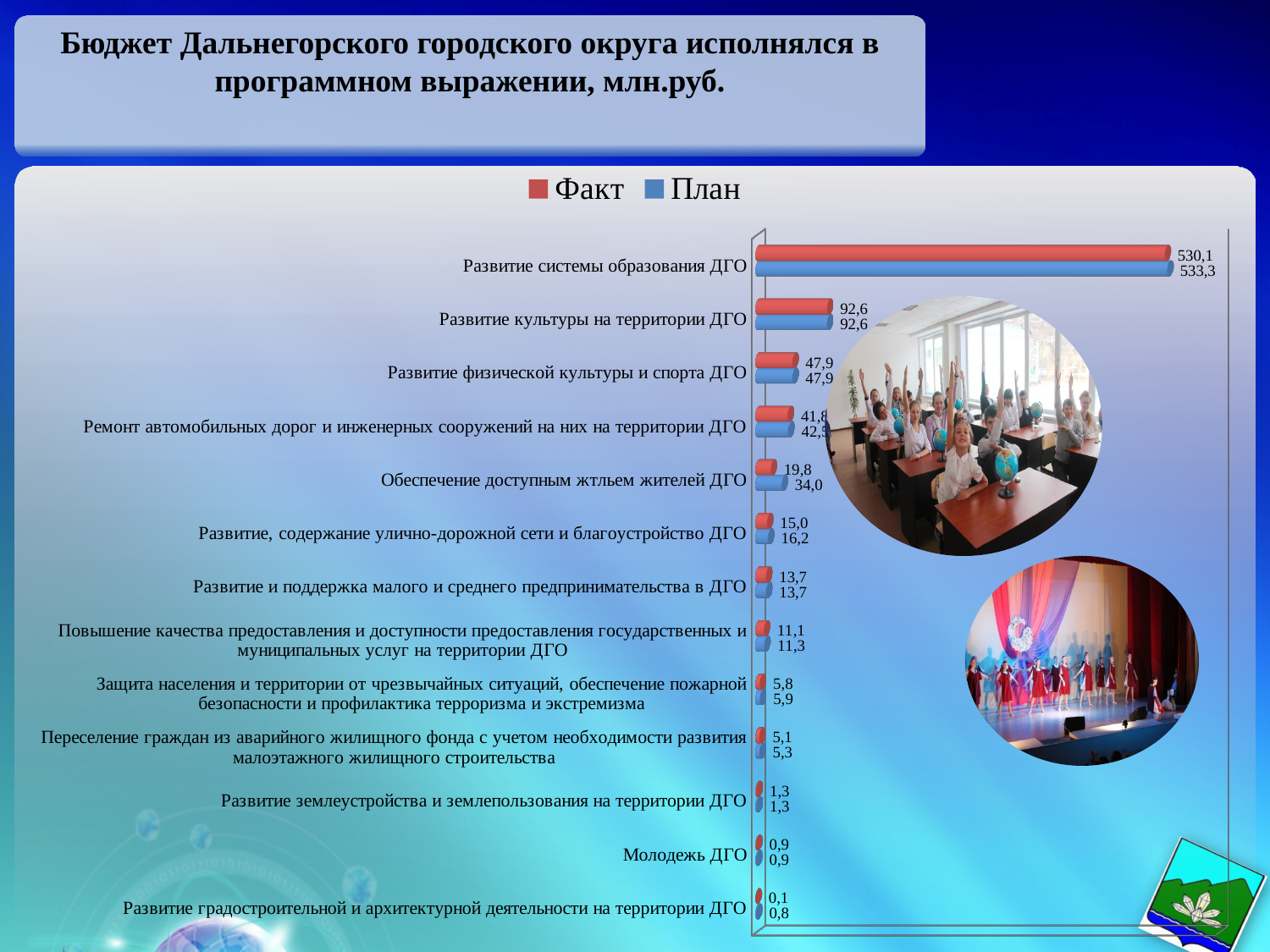
What type of chart is shown on the slide? Bar chart How many series does the legend list? 2 What is the План value for Развитие градостроительной и архитектурной деятельности на территории ДГО? 0,8 How many categories are shown in the chart? 13 Which category has the highest Факт value? Развитие системы образования ДГО Which is larger for Развитие, содержание улично-дорожной сети и благоустройство ДГО: the Факт value or the План value? План What is the Факт value for Развитие системы образования ДГО? 530,1 What is the Факт value for Развитие, содержание улично-дорожной сети и благоустройство ДГО? 15,0 What is the difference between the План and Факт values for Обеспечение доступным жтльем жителей ДГО? 14,2 What is the План value for Обеспечение доступным жтльем жителей ДГО? 34,0 What is the difference between the План and Факт values for Развитие системы образования ДГО? 3,2 Which category has the lowest Факт value? Развитие градостроительной и архитектурной деятельности на территории ДГО